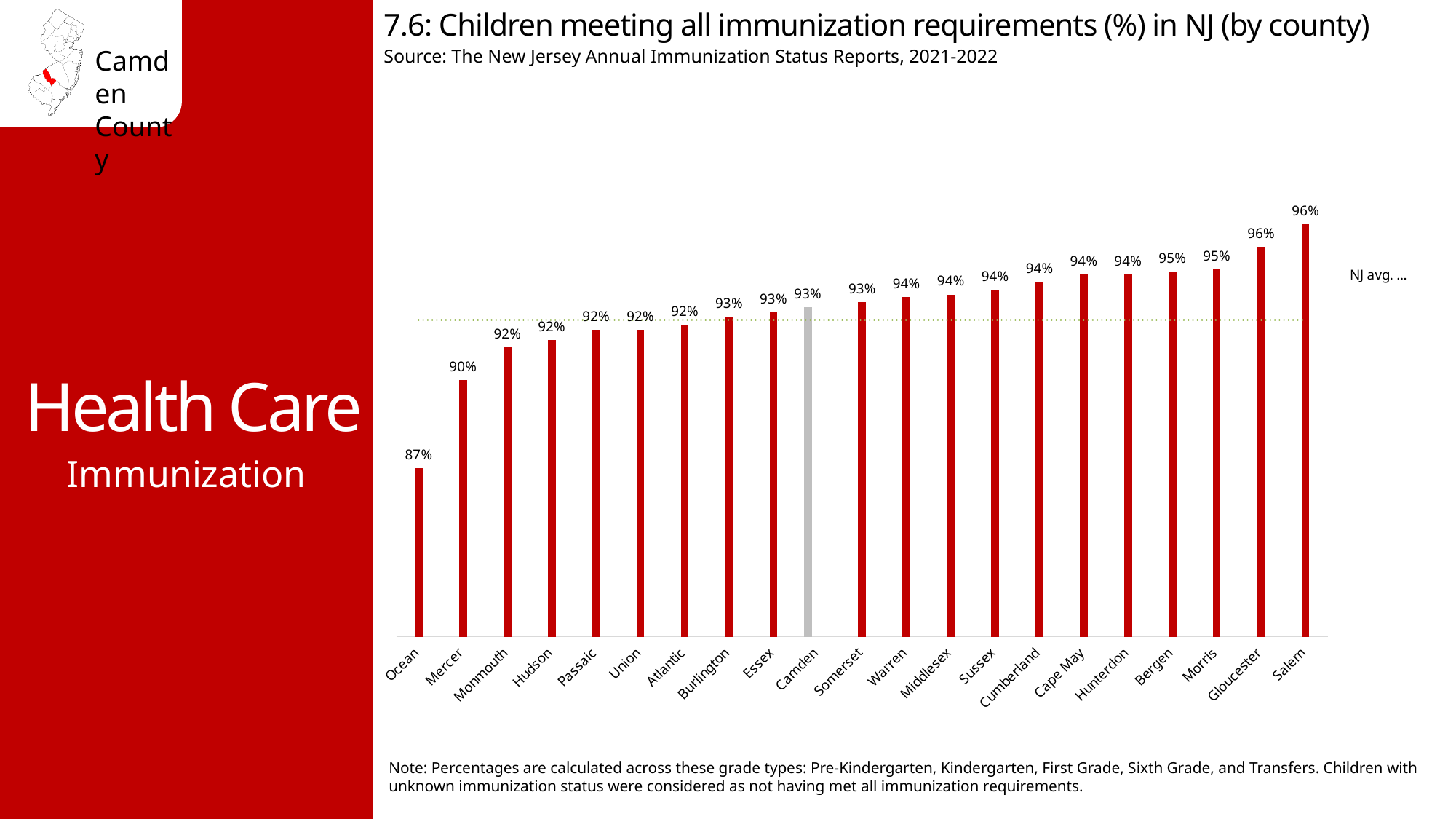
Which has a higher value, Mercer County or Camden County? Camden How many counties are shown on the chart? 21 What is the value shown for Mercer County? 90% What is the difference in percentage points between Salem County and Ocean County? 9 percentage points What percentage of children in Camden County met all immunization requirements? 93% What is the value shown for Ocean County? 87% Do the values generally rise or fall moving from left to right along the x axis? Rise Which county's bar is coloured grey instead of red? Camden What is the difference in percentage points between Camden County and Mercer County? 3 percentage points What kind of chart is used on this slide? Bar chart What is the value shown for Bergen County? 95% Which county has the lowest percentage of children meeting all immunization requirements? Ocean